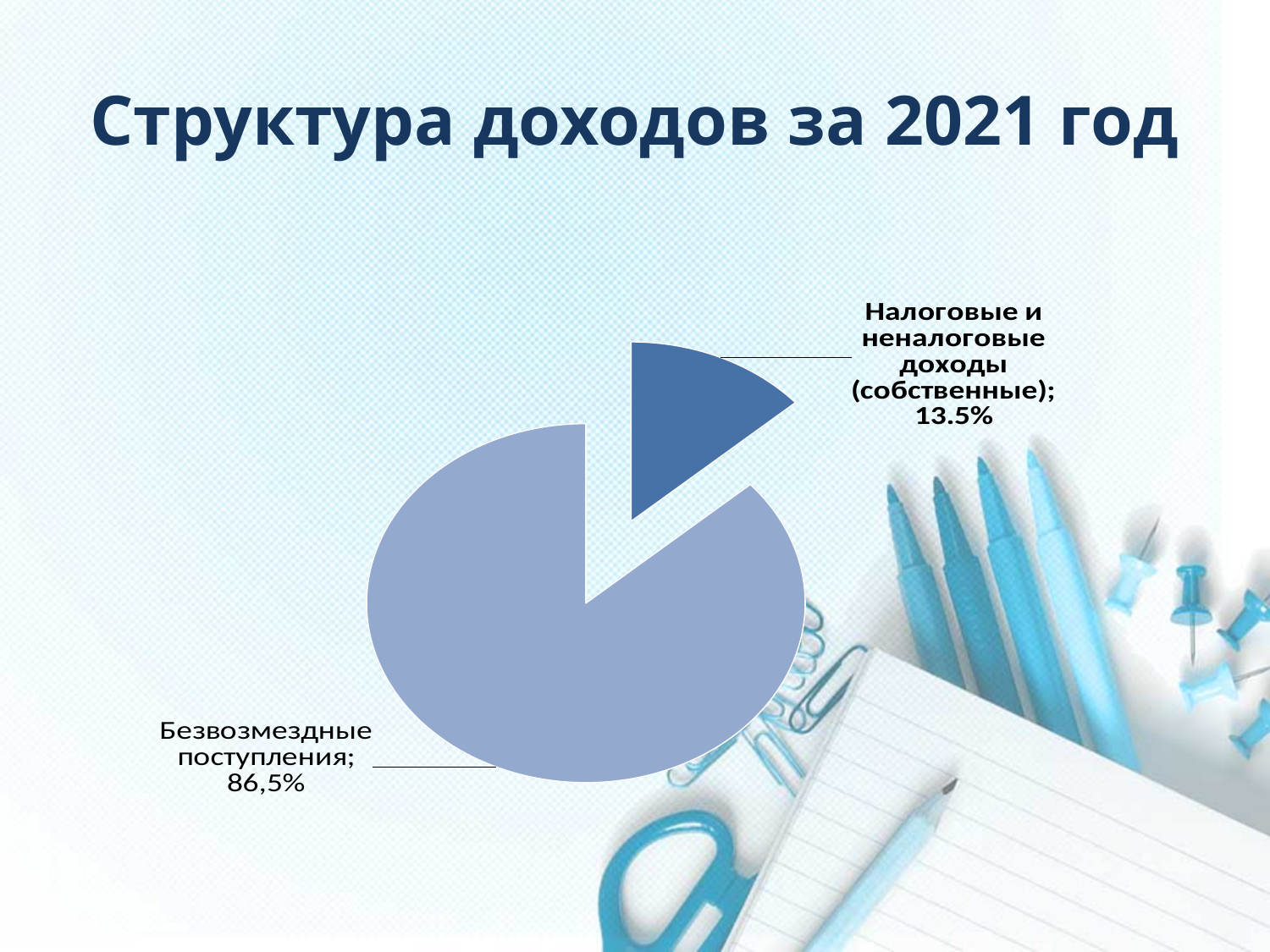
What is the difference in percentage points between the share of "Безвозмездные поступления" and the share of "Налоговые и неналоговые доходы (собственные)"? 73 percentage points What kind of chart is shown on the slide? pie chart Which slice of the pie chart is the smallest? Налоговые и неналоговые доходы (собственные) What is the share of "Безвозмездные поступления" in the pie chart? 86,5% Which slice of the pie chart is the largest? Безвозмездные поступления What is the title of the slide containing the pie chart? Структура доходов за 2021 год Which is larger: the share of "Безвозмездные поступления" or the share of "Налоговые и неналоговые доходы (собственные)"? Безвозмездные поступления What is the share of "Налоговые и неналоговые доходы (собственные)" in the pie chart? 13.5% How many slices does the pie chart have? 2 Which slice of the pie chart is pulled out (exploded) from the rest of the pie? Налоговые и неналоговые доходы (собственные)